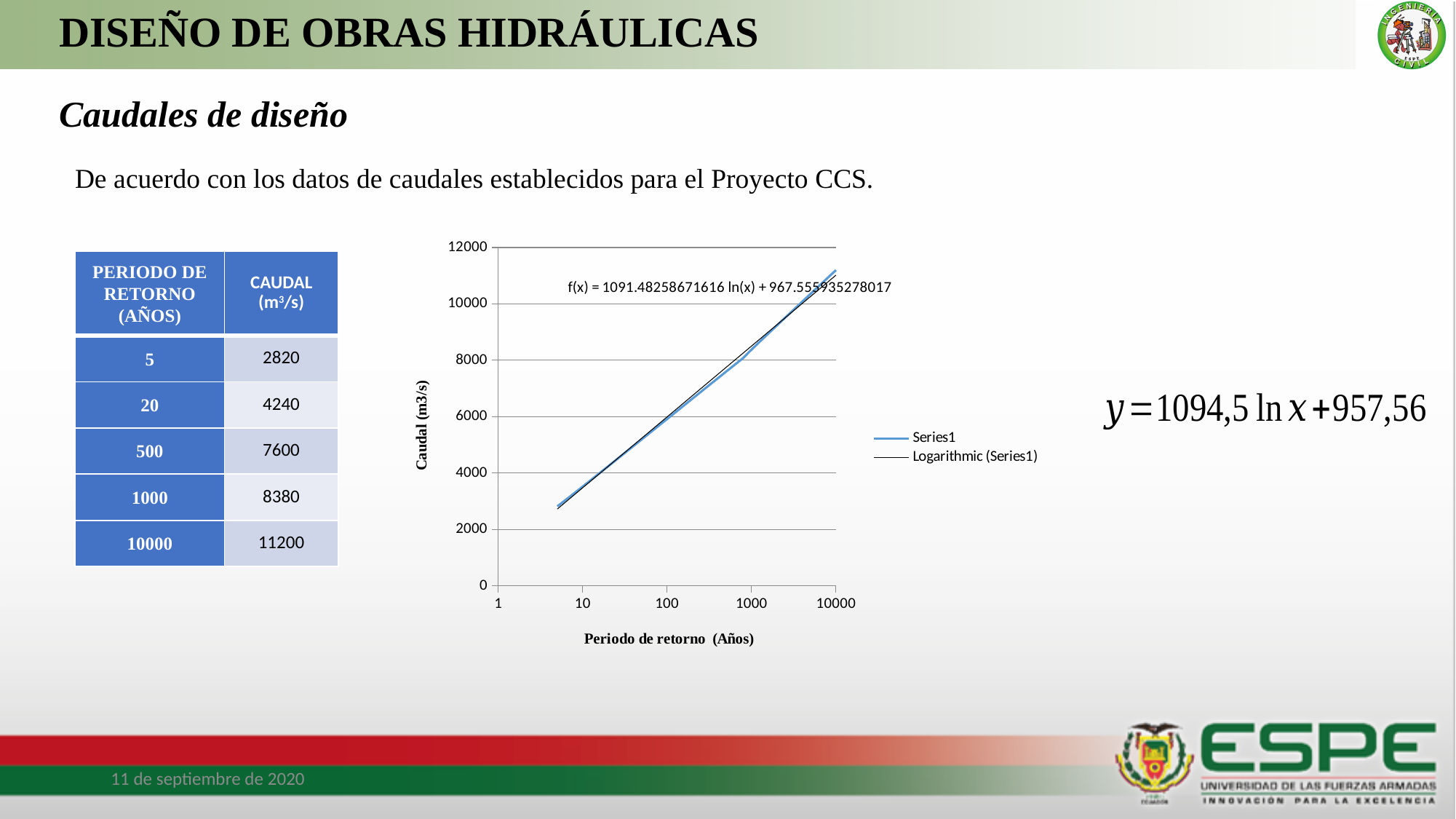
What is the title of the x axis of the chart? Periodo de retorno (Años) Does the Caudal value rise or fall as the Periodo de retorno increases along the x axis? rise Is the lowest point of Series1 greater or less than 4000? less How many series does the chart legend list? 2 What kind of chart is shown on the slide? line chart What trendline equation is displayed on the chart? f(x) = 1091.48258671616 ln(x) + 967.555935278017 Is the Series1 value at a Periodo de retorno of 10000 years greater or less than 10000? greater At which Periodo de retorno shown on the x axis does Series1 reach its highest Caudal? 10000 Is the Series1 value at a Periodo de retorno of 1000 years greater or less than 6000? greater